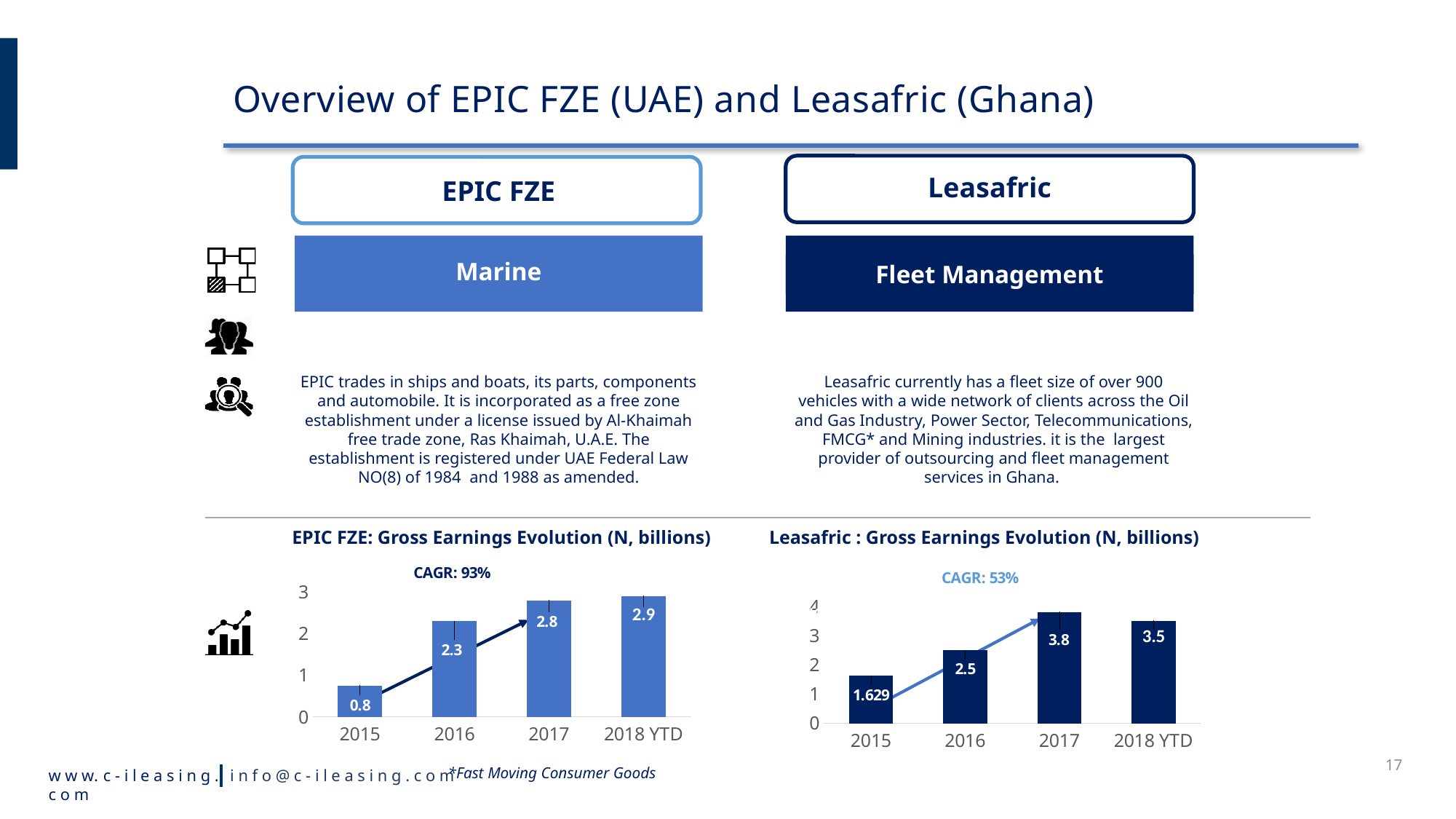
In the EPIC FZE: Gross Earnings Evolution chart, what is the value for 2018 YTD? 2.9 In the EPIC FZE: Gross Earnings Evolution chart, what is the value for 2016? 2.3 In the Leasafric : Gross Earnings Evolution chart, what is the value for 2017? 3.8 In the EPIC FZE: Gross Earnings Evolution chart, which year has the lowest value? 2015 What CAGR is shown above the EPIC FZE: Gross Earnings Evolution chart? CAGR: 93% In the Leasafric : Gross Earnings Evolution chart, what is the difference between the 2017 and 2018 YTD values? 0.3 In the Leasafric : Gross Earnings Evolution chart, what is the value for 2015? 1.629 In the Leasafric : Gross Earnings Evolution chart, which year has the highest value? 2017 In the EPIC FZE: Gross Earnings Evolution chart, what is the difference between the 2017 and 2016 values? 0.5 How many years are shown on the x axis of the EPIC FZE: Gross Earnings Evolution chart? 4 What kind of chart is the Leasafric : Gross Earnings Evolution chart? Bar chart In the Leasafric : Gross Earnings Evolution chart, which is larger, the value for 2016 or the value for 2018 YTD? 2018 YTD